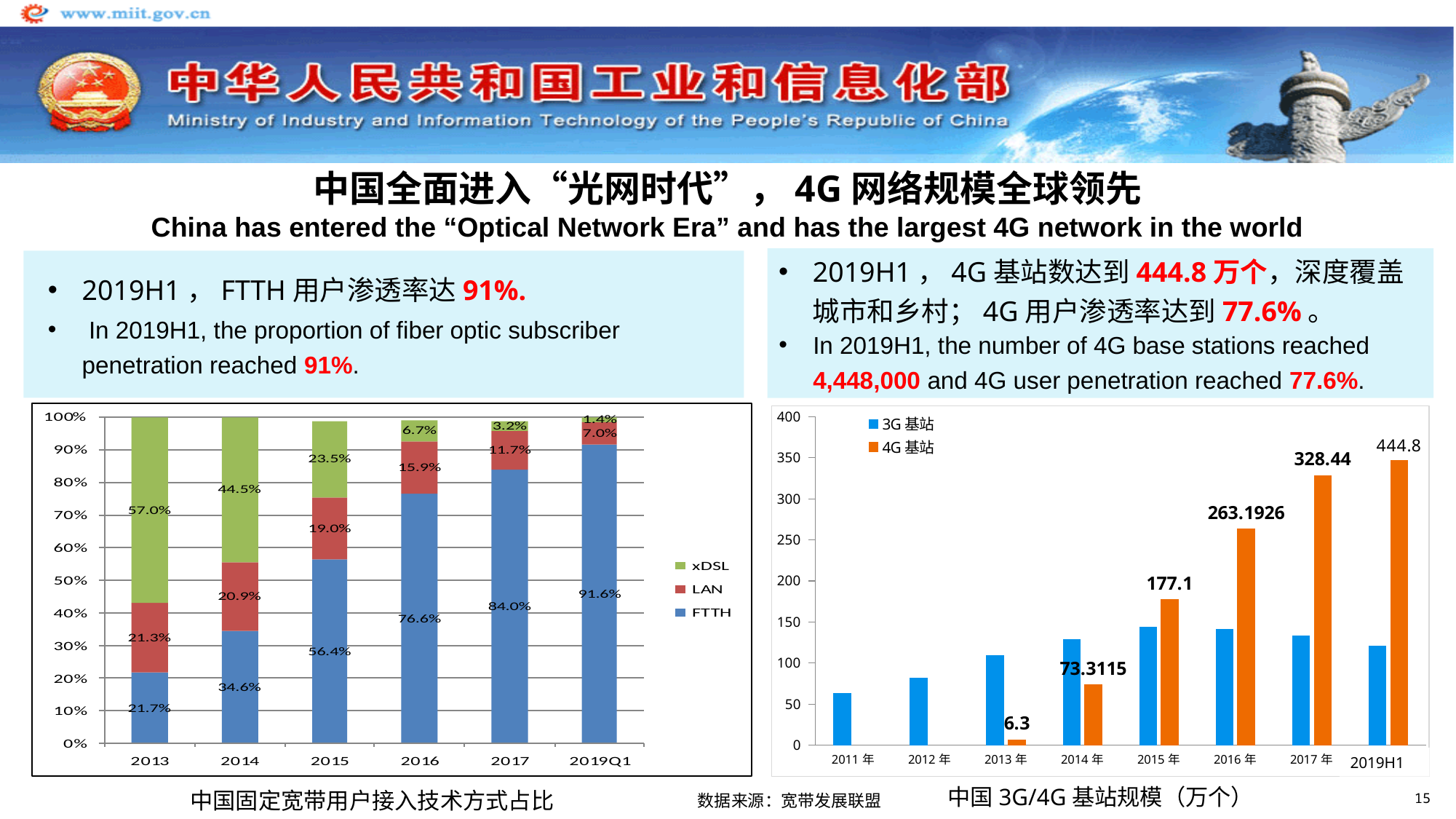
In the left chart (中国固定宽带用户接入技术方式占比), what is the FTTH share in 2019Q1? 91.6% In the right chart (中国 3G/4G 基站规模), is the 3G 基站 value for 2011 年 greater or less than 100? less In the left chart (中国固定宽带用户接入技术方式占比), does the FTTH share rise or fall from 2013 to 2019Q1? rise In the left chart (中国固定宽带用户接入技术方式占比), what is the difference between the FTTH share in 2017 and in 2016? 7.4% In the right chart (中国 3G/4G 基站规模), what is the value for 4G 基站 in 2017 年? 328.44 In the left chart (中国固定宽带用户接入技术方式占比), what is the LAN share in 2015? 19.0% In the left chart (中国固定宽带用户接入技术方式占比), which year has the lowest FTTH share? 2013 In the left chart (中国固定宽带用户接入技术方式占比), how many series does the legend list? 3 In the right chart (中国 3G/4G 基站规模), what is the value for 4G 基站 in 2014 年? 73.3115 In the left chart (中国固定宽带用户接入技术方式占比), what is the xDSL share in 2013? 57.0% In the right chart (中国 3G/4G 基站规模), which year has the highest 4G 基站 value? 2019H1 In the right chart (中国 3G/4G 基站规模), what kind of chart is shown? bar chart